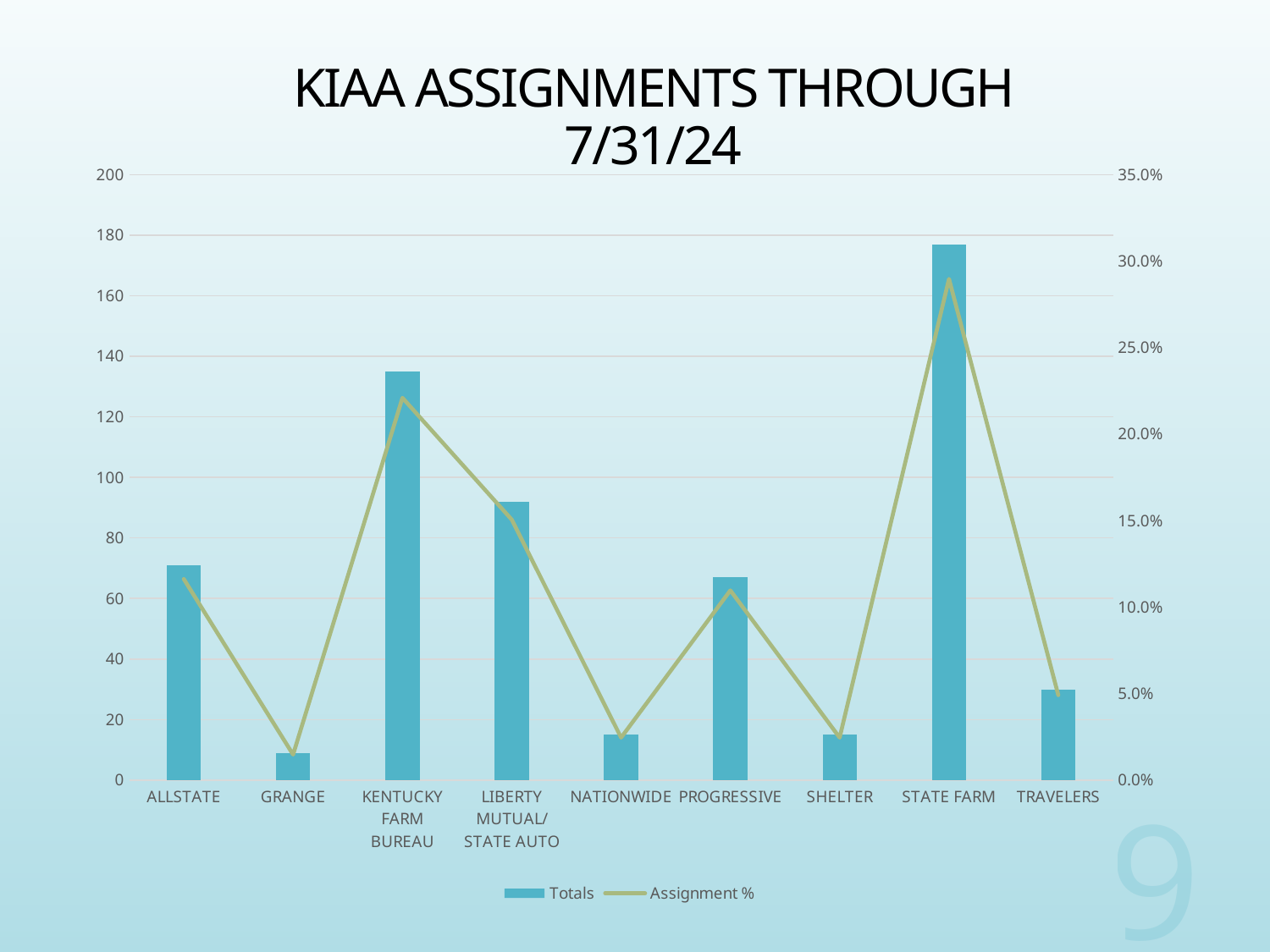
How many series does the legend list? 2 Is the Totals value for Grange greater or less than 20? less Which has a larger Totals bar, Travelers or Grange? Travelers Which category has the highest Totals bar? State Farm Which category has the lowest Totals bar? Grange Is the Totals value for Kentucky Farm Bureau greater or less than 120? greater What is the title of the chart? KIAA ASSIGNMENTS THROUGH 7/31/24 How many categories are shown on the x axis? 9 Is the Totals value for State Farm greater or less than 160? greater Which has a larger Totals bar, Kentucky Farm Bureau or Liberty Mutual/State Auto? Kentucky Farm Bureau